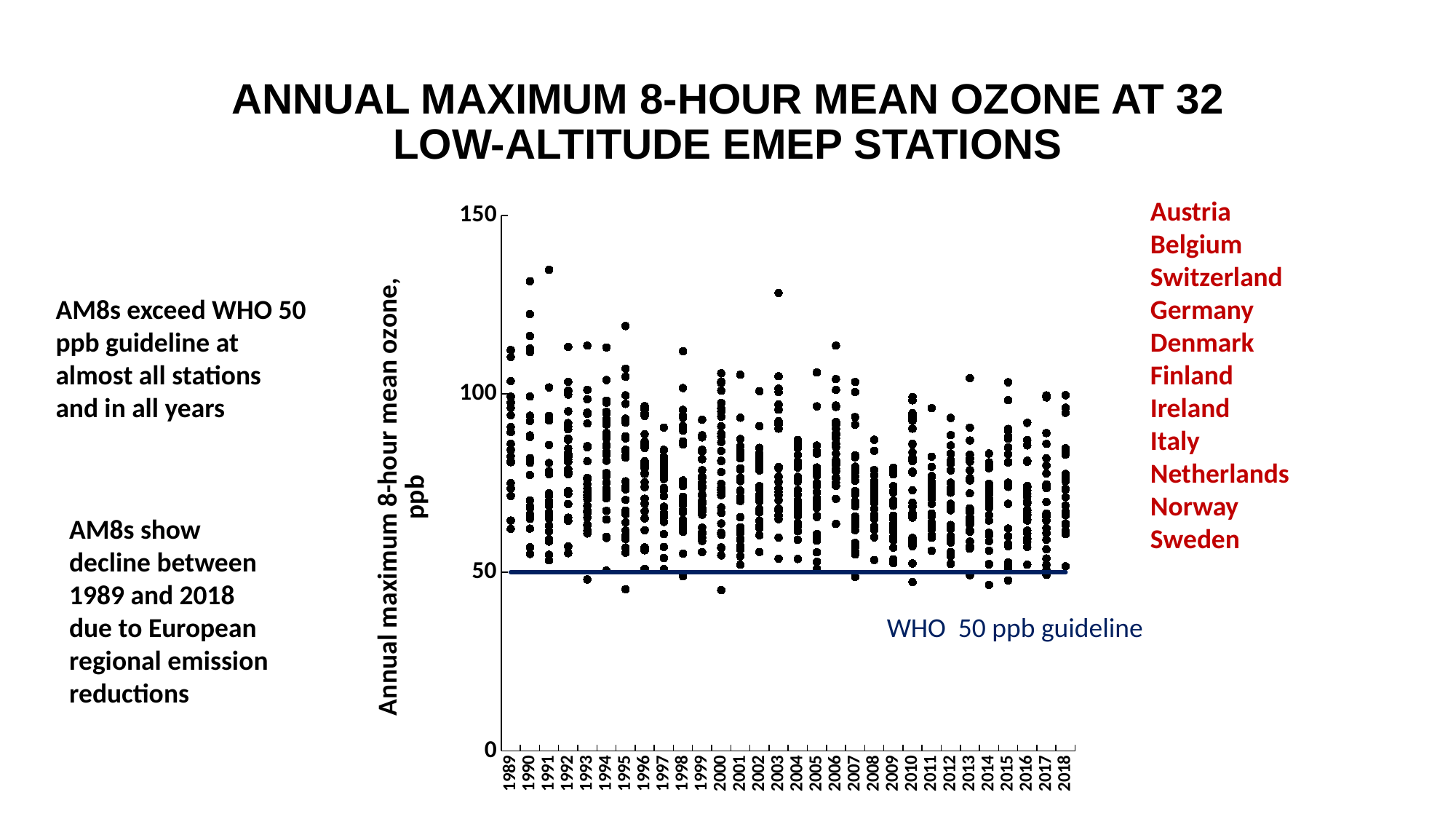
How many countries are listed to the right of the chart? 11 Is the highest plotted value in 1991 greater or less than 100? greater What is the highest tick value shown on the y axis? 150 What is the title of the chart on the slide? Annual maximum 8-hour mean ozone at 32 low-altitude EMEP stations What is the label of the y axis of the chart? Annual maximum 8-hour mean ozone, ppb At what value is the WHO guideline line drawn on the chart? 50 ppb Is the lowest plotted value in 2000 greater or less than 50? less What kind of chart is shown on the slide? scatter plot How many years are shown along the x axis of the chart? 30 What is the last year shown on the x axis? 2018 Do the plotted ozone values generally rise or fall from 1989 to 2018? fall What is the first year shown on the x axis? 1989